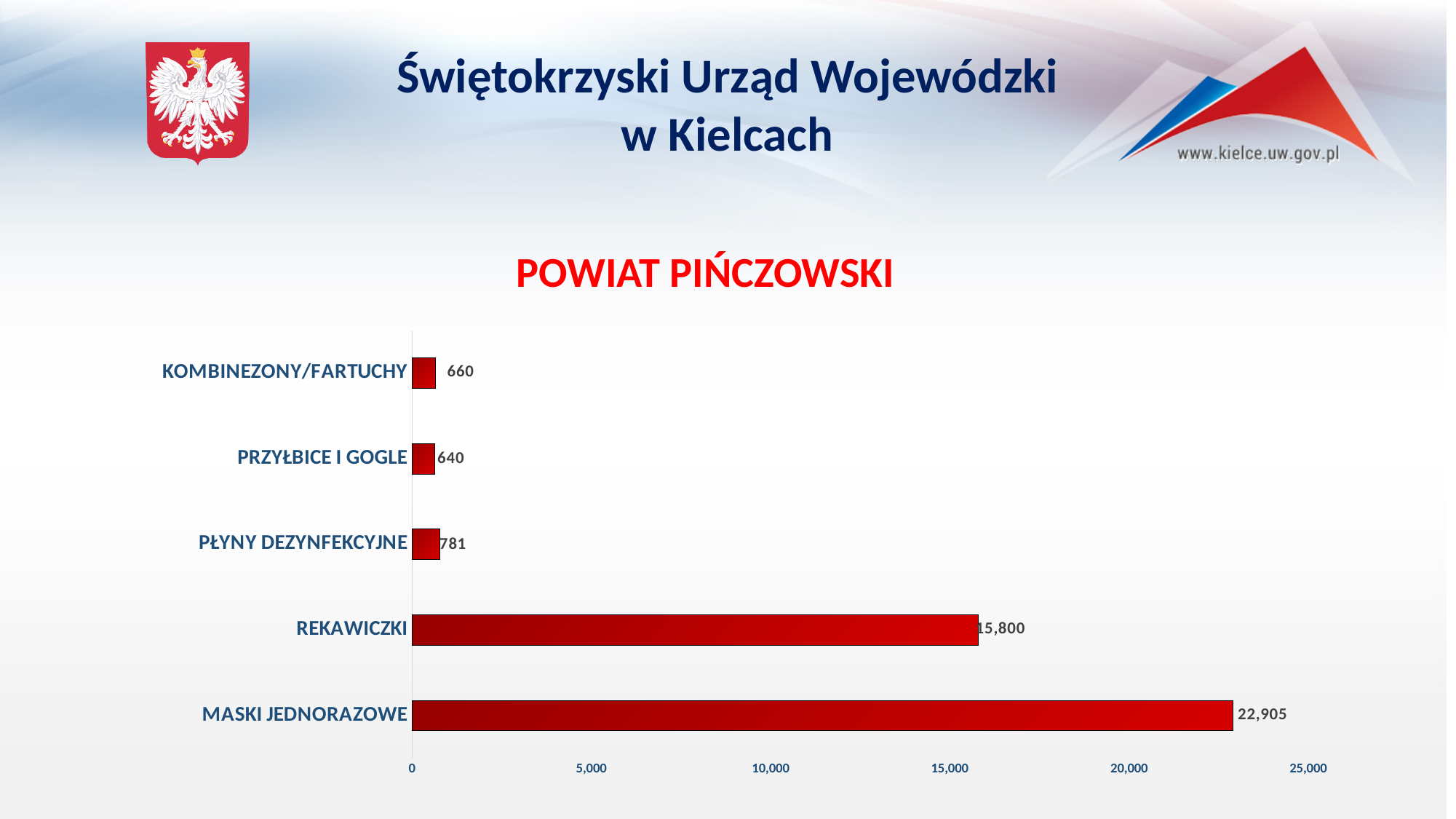
What is the value for PŁYNY DEZYNFEKCYJNE? 781 Which category has the highest value? MASKI JEDNORAZOWE Is the value for REKAWICZKI greater or less than 15,000? greater How many categories are shown in the chart? 5 Which is larger, the value for PŁYNY DEZYNFEKCYJNE or the value for KOMBINEZONY/FARTUCHY? PŁYNY DEZYNFEKCYJNE What kind of chart is shown on the slide? bar chart What is the value for KOMBINEZONY/FARTUCHY? 660 What is the value for REKAWICZKI? 15,800 What is the difference between the values for MASKI JEDNORAZOWE and REKAWICZKI? 7,105 What is the value for MASKI JEDNORAZOWE? 22,905 Which category has the lowest value? PRZYŁBICE I GOGLE What is the value for PRZYŁBICE I GOGLE? 640